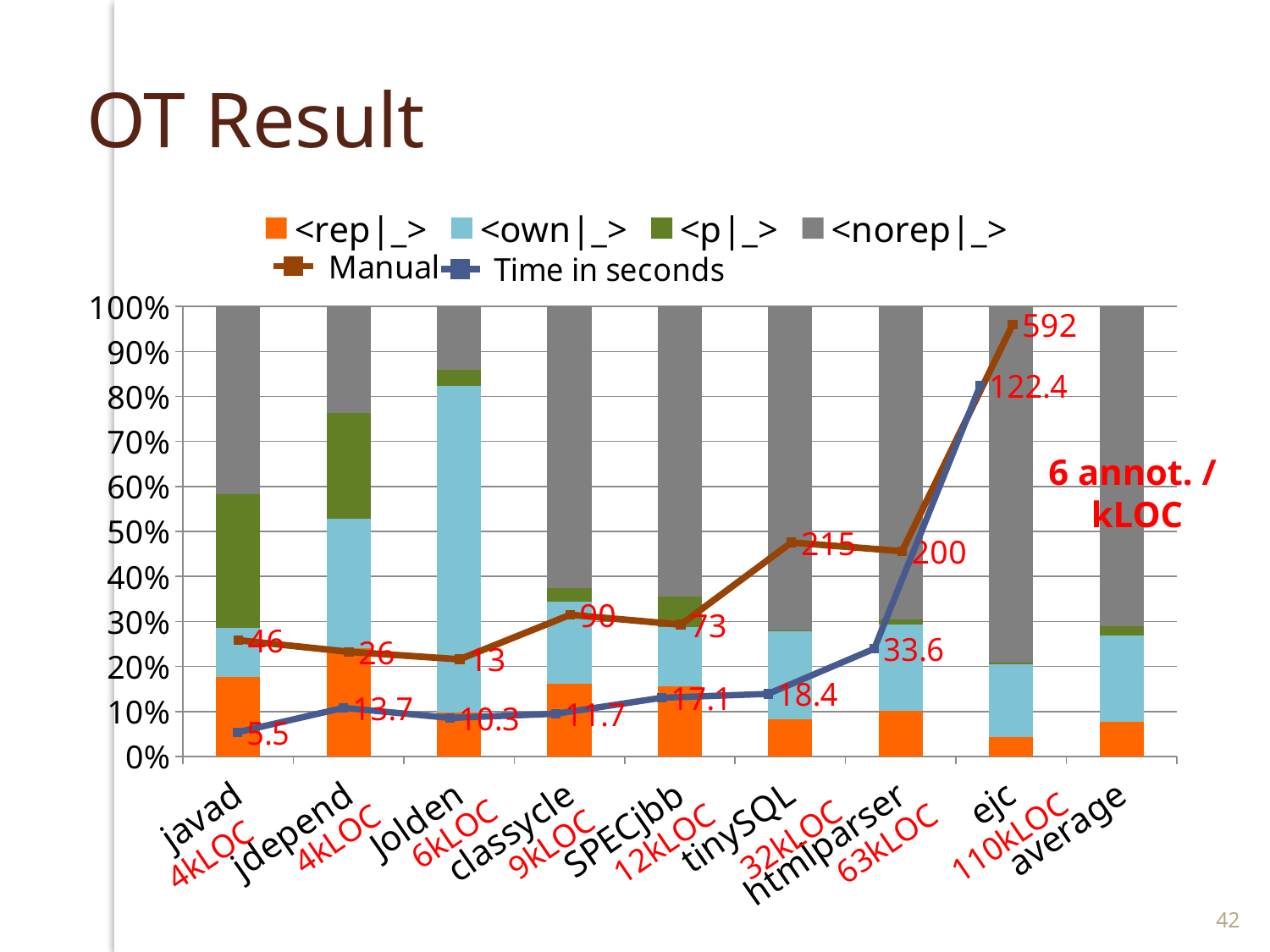
Which category has the highest Manual value? ejc Which category has the lowest Manual value? Jolden Which has a larger Time in seconds value, htmlparser or SPECjbb? htmlparser What is the Manual value for tinySQL? 215 In the javad bar, does the top of the <p|_> segment lie above or below 50%? above What is the difference between the Manual values for ejc and htmlparser? 392 How many categories are shown on the x axis? 9 What is the difference between the Time in seconds values for ejc and htmlparser? 88.8 What is the Time in seconds value for ejc? 122.4 What colour represents the <rep|_> series in the legend? Orange How many series does the legend list? 6 Which category has the lowest Time in seconds value? javad